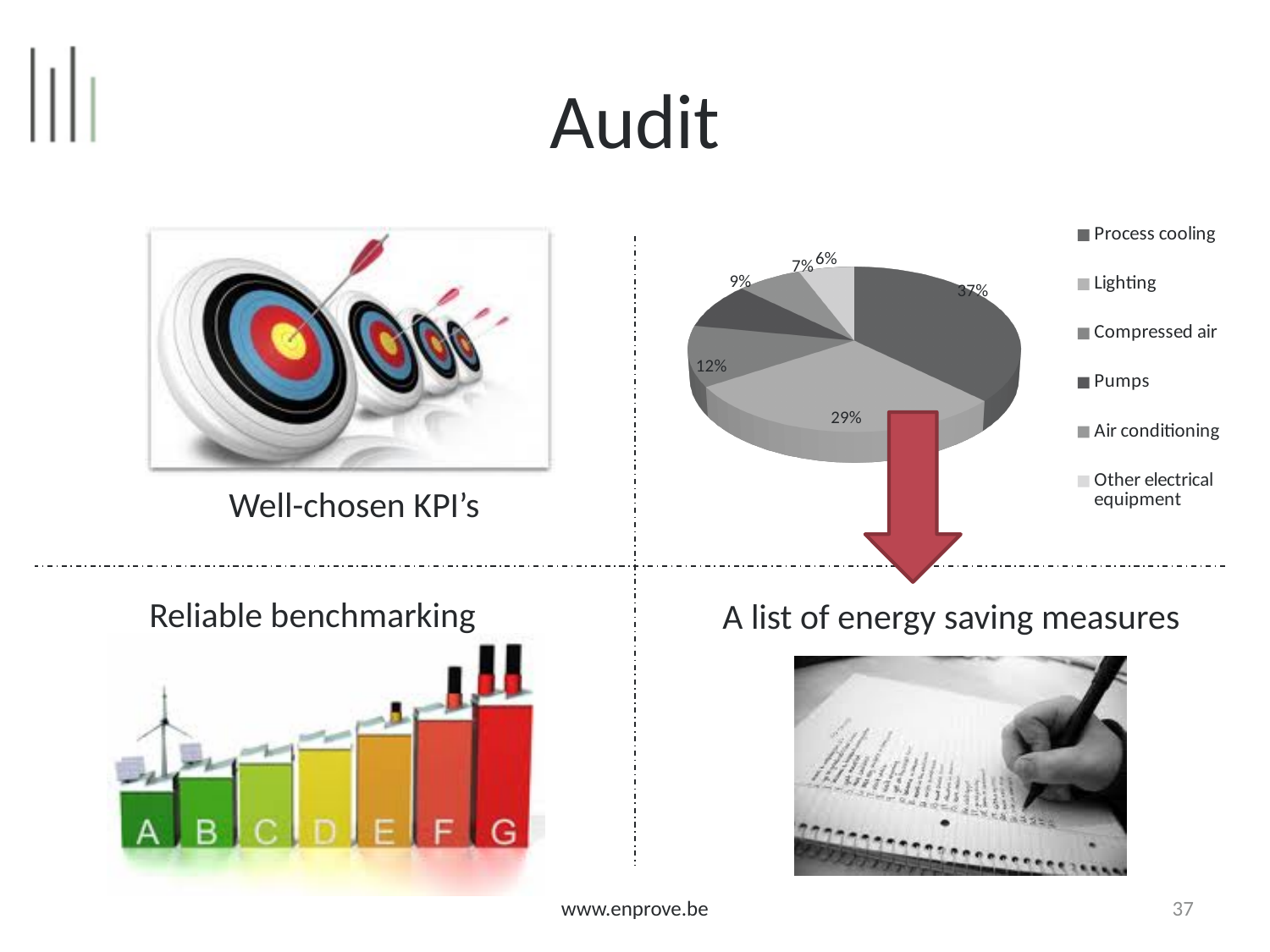
What percentage is shown for Lighting in the pie chart? 29% Which category has the smallest slice in the pie chart? Other electrical equipment What percentage is shown for Compressed air in the pie chart? 12% What share of the pie chart does Process cooling account for? 37% What percentage is shown for Pumps in the pie chart? 9% Which is larger in the pie chart, Compressed air or Pumps? Compressed air How many categories does the pie chart's legend list? 6 Which category has the largest slice in the pie chart? Process cooling What is the combined share of Air conditioning and Other electrical equipment in the pie chart? 13% What percentage is shown for Other electrical equipment in the pie chart? 6% What is the difference in percentage points between Process cooling and Lighting in the pie chart? 8 What kind of chart is shown on the slide? Pie chart